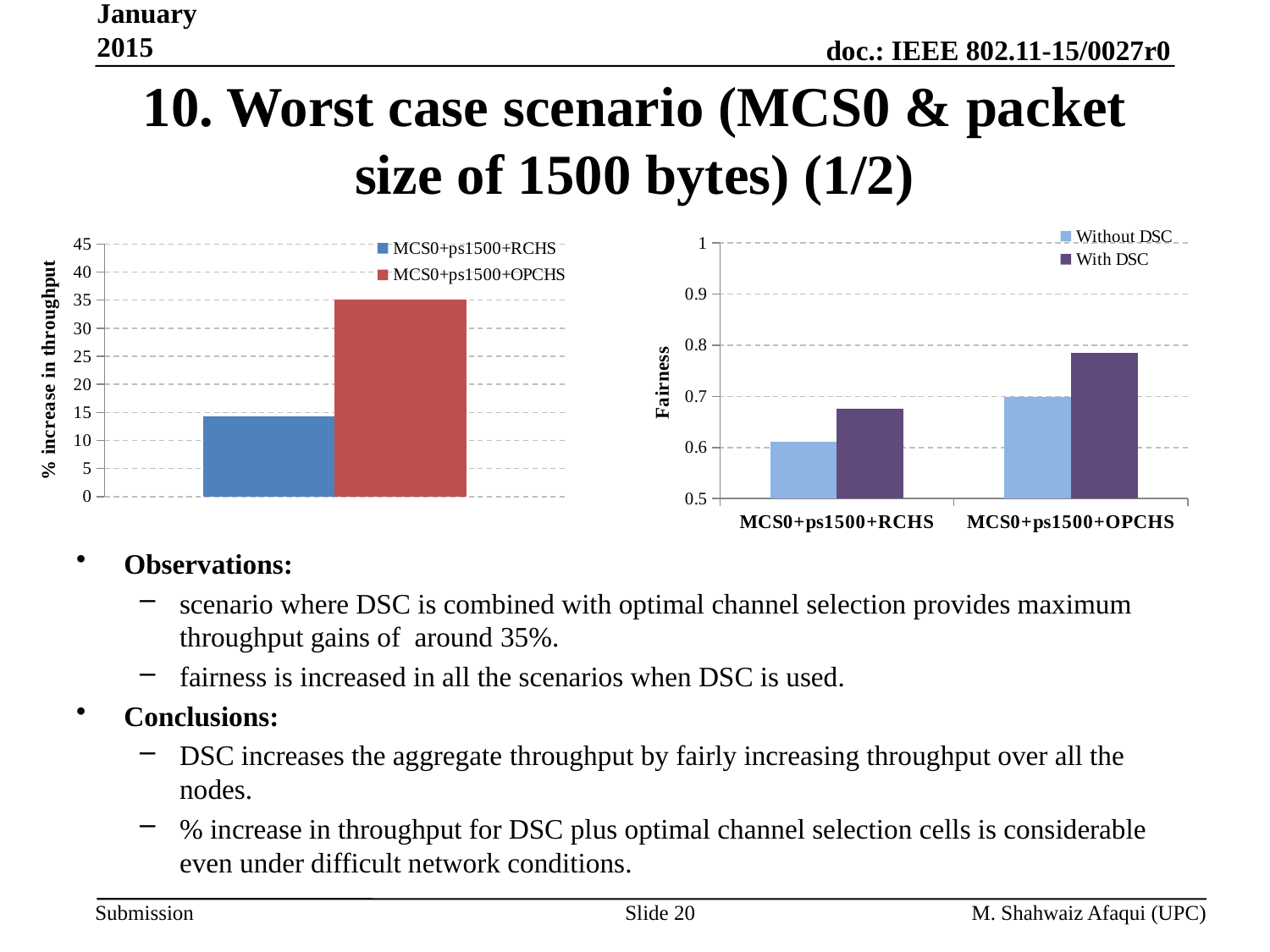
On the left chart (% increase in throughput), how many series does the legend list? 2 On the right chart (Fairness), how many series does the legend list? 2 On the left chart (% increase in throughput), is the value for MCS0+ps1500+RCHS greater or less than 20? less On the left chart (% increase in throughput), is the value for MCS0+ps1500+OPCHS greater or less than 30? greater On the right chart (Fairness), is the With DSC value for MCS0+ps1500+RCHS greater or less than 0.7? less On the right chart (Fairness), which is larger for MCS0+ps1500+OPCHS: Without DSC or With DSC? With DSC On the left chart (% increase in throughput), what kind of chart is shown? bar chart On the right chart (Fairness), which category has the highest Without DSC value? MCS0+ps1500+OPCHS On the left chart (% increase in throughput), which series has the higher value? MCS0+ps1500+OPCHS On the left chart (% increase in throughput), what is the label of the y axis? % increase in throughput On the right chart (Fairness), how many categories are shown on the x axis? 2